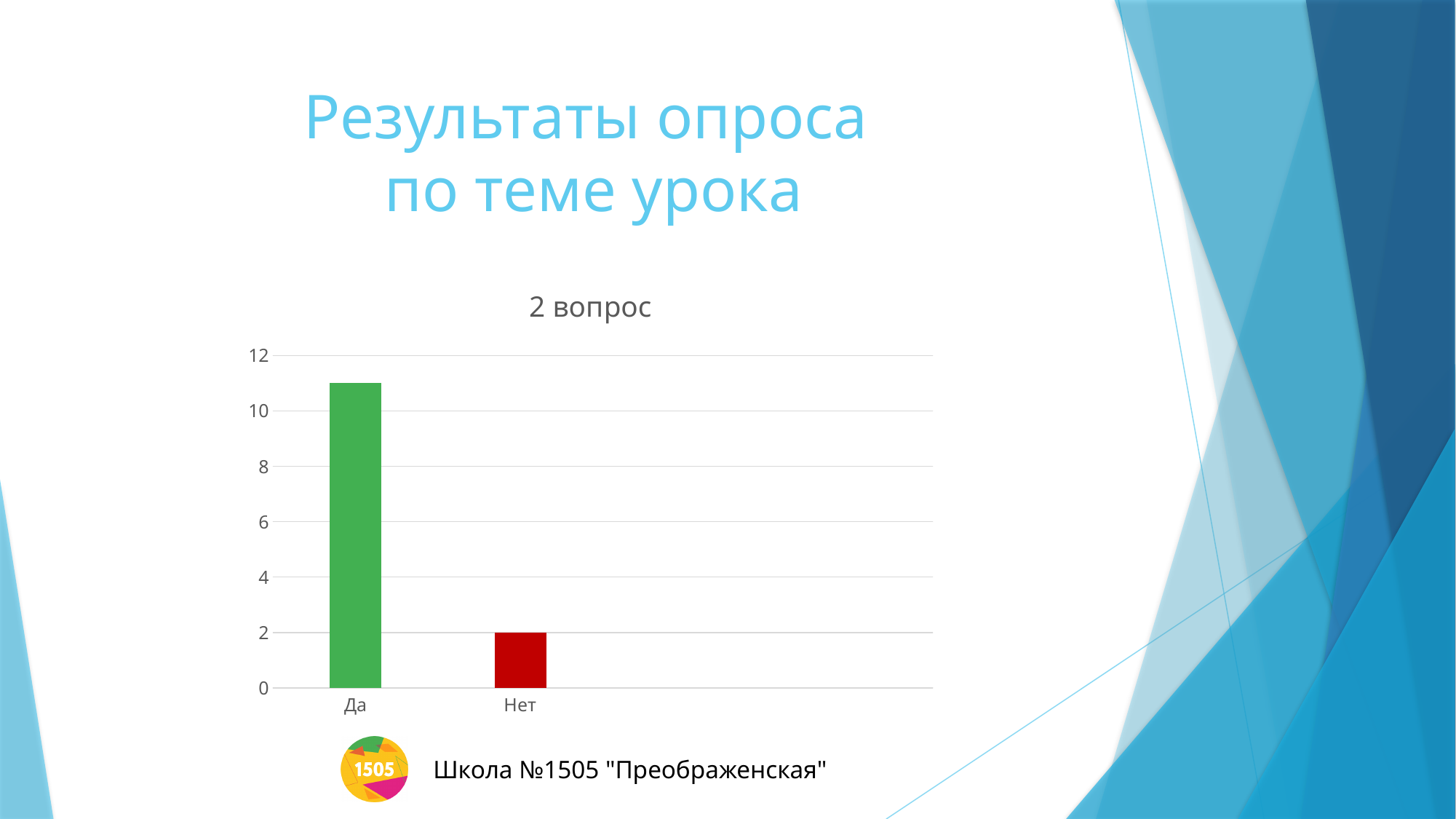
Which category has the lowest value? Нет What colour is the bar for Да? green Which is larger, the value for Да or the value for Нет? Да How many categories are shown on the x axis of the chart? 2 Which category has the highest value? Да Is the value for Нет greater or less than 4? less Do the values rise or fall from Да to Нет along the x axis? fall Is the value for Да greater or less than 12? less What type of chart is shown on the slide? bar chart What is the value for Нет? 2 What is the title of the chart? 2 вопрос Is the value for Да greater or less than 10? greater